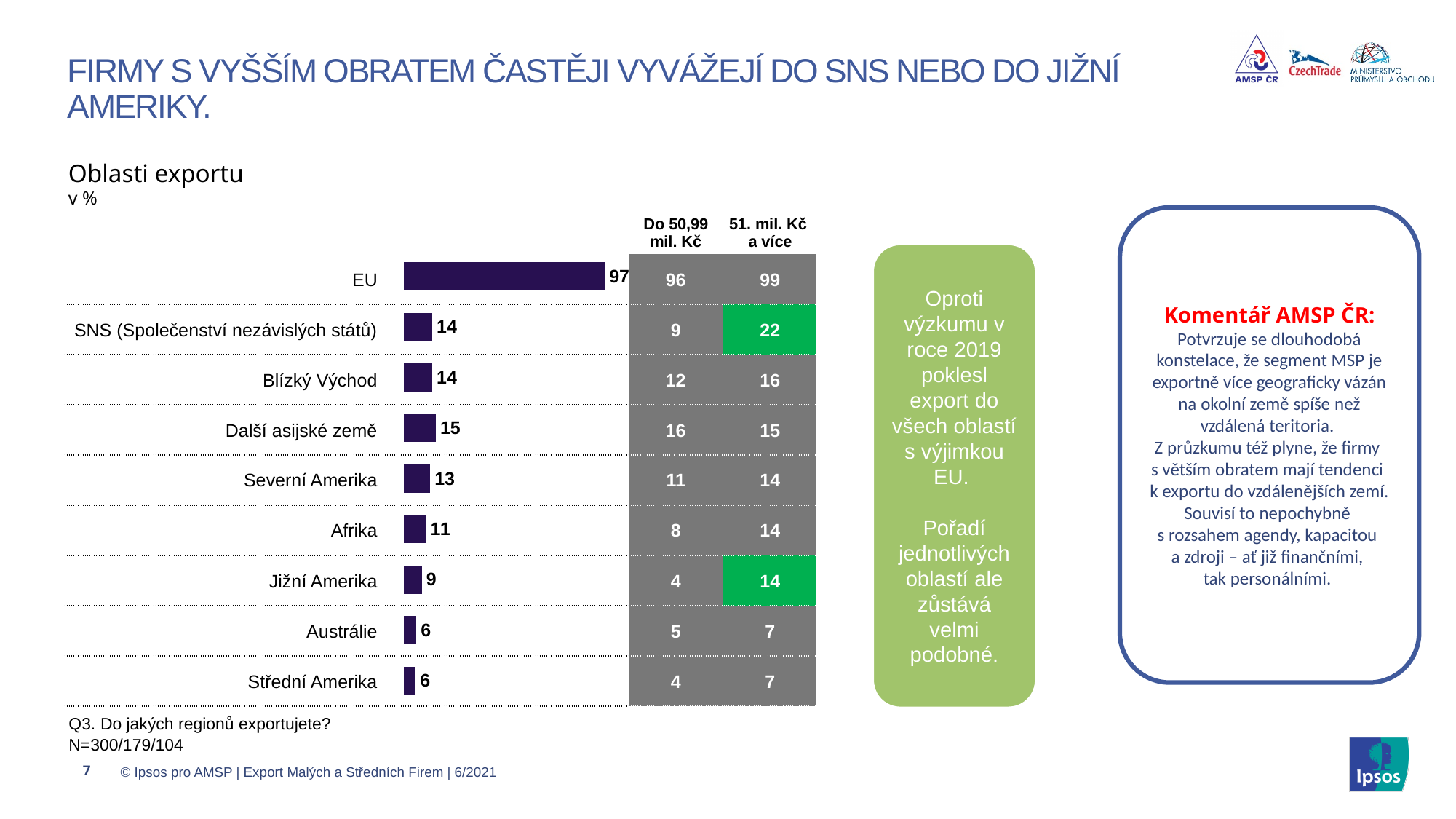
What is the value for Další asijské země in the Oblasti exportu chart? 15 In the Oblasti exportu chart, which is larger: the value for Další asijské země or the value for Afrika? Další asijské země How many categories are shown in the Oblasti exportu chart? 9 What is the difference between the values for EU and SNS (Společenství nezávislých států) in the Oblasti exportu chart? 83 Which category has the highest value in the Oblasti exportu chart? EU What is the value for EU in the Oblasti exportu chart? 97 What is the value for Afrika in the Oblasti exportu chart? 11 What kind of chart is the Oblasti exportu chart? bar chart What is the difference between the values for Severní Amerika and Jižní Amerika in the Oblasti exportu chart? 4 What is the value for Jižní Amerika in the Oblasti exportu chart? 9 In what unit are the values in the Oblasti exportu chart expressed? % What is the title of the chart on the slide? Oblasti exportu